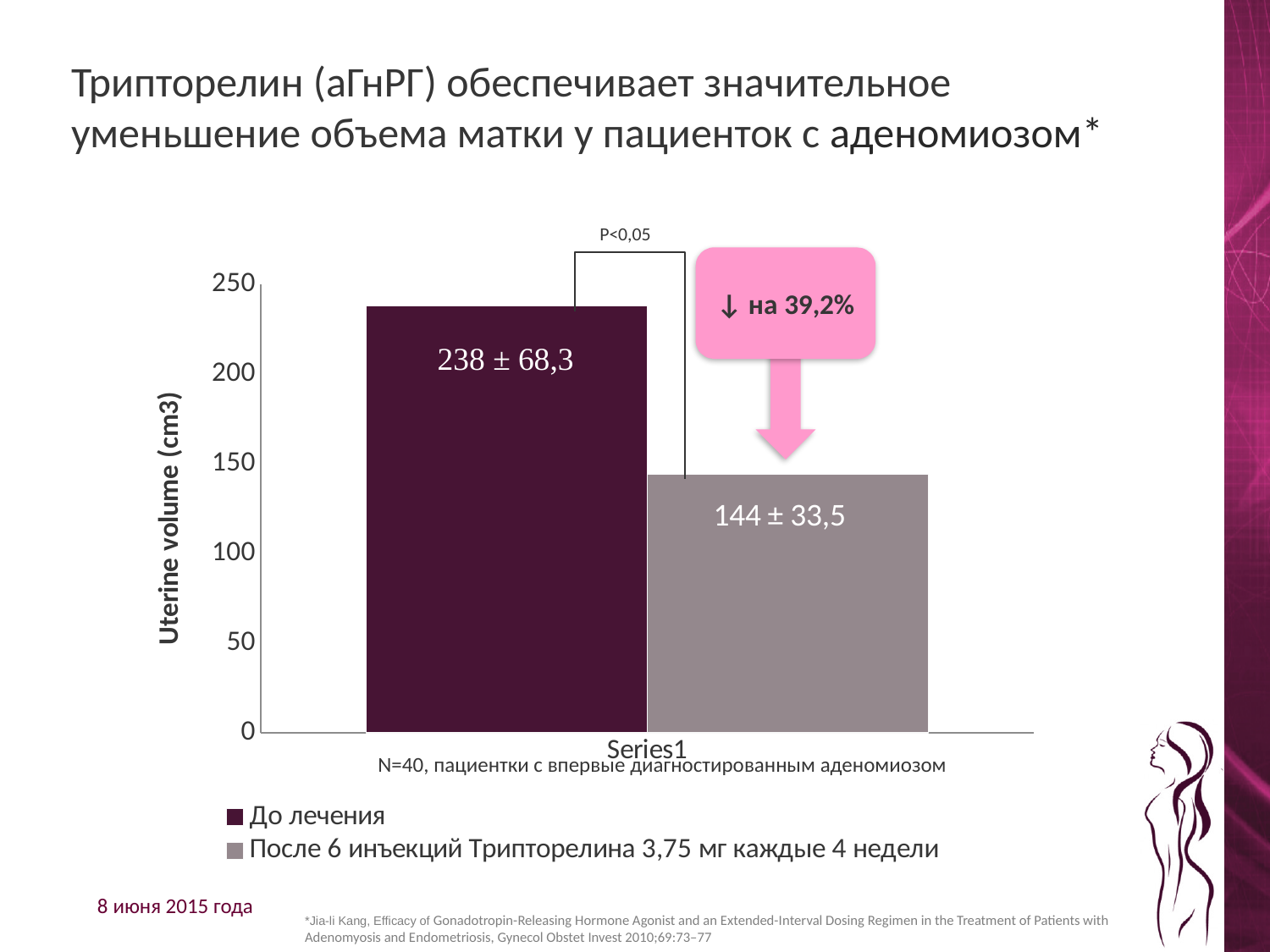
What is the difference between the mean uterine volume before treatment (238) and after treatment (144)? 94 Is the value for 'После 6 инъекций Трипторелина 3,75 мг каждые 4 недели' greater or less than 150? less Is the value for 'До лечения' greater or less than 200? greater Which series shows the lowest uterine volume? После 6 инъекций Трипторелина 3,75 мг каждые 4 недели How many series does the legend list? 2 How many bars are plotted in the chart? 2 What percentage decrease is shown in the pink callout on the chart? 39,2% What is the label of the vertical axis? Uterine volume (cm3) What is the uterine volume shown for the 'До лечения' bar? 238 ± 68,3 Which series has the higher uterine volume, 'До лечения' or 'После 6 инъекций Трипторелина 3,75 мг каждые 4 недели'? До лечения What type of chart is shown on the slide? bar chart What is the uterine volume shown for the 'После 6 инъекций Трипторелина 3,75 мг каждые 4 недели' bar? 144 ± 33,5